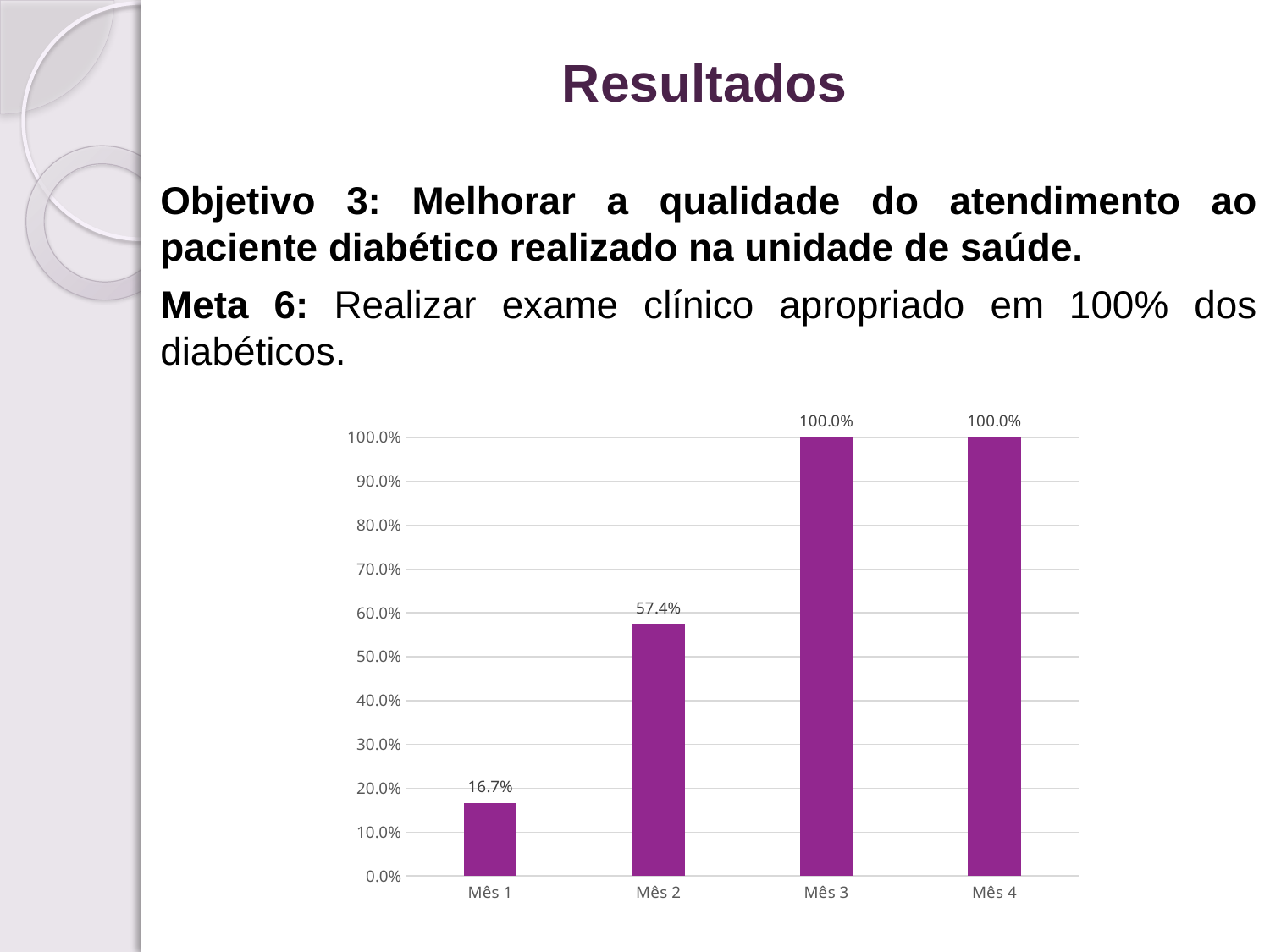
What is the value for Mês 2? 57.4% What is the value for Mês 1? 16.7% Is the value for Mês 2 greater or less than 50.0%? greater What is the value for Mês 4? 100.0% What kind of chart is shown on the slide? bar chart What is the difference between the values for Mês 2 and Mês 1? 40.7% How many months are shown on the x axis? 4 Which is larger, the value for Mês 2 or the value for Mês 1? Mês 2 What is the difference between the values for Mês 3 and Mês 2? 42.6% What is the value for Mês 3? 100.0% Do the values rise or fall from Mês 1 to Mês 3? rise Which month has the lowest value? Mês 1